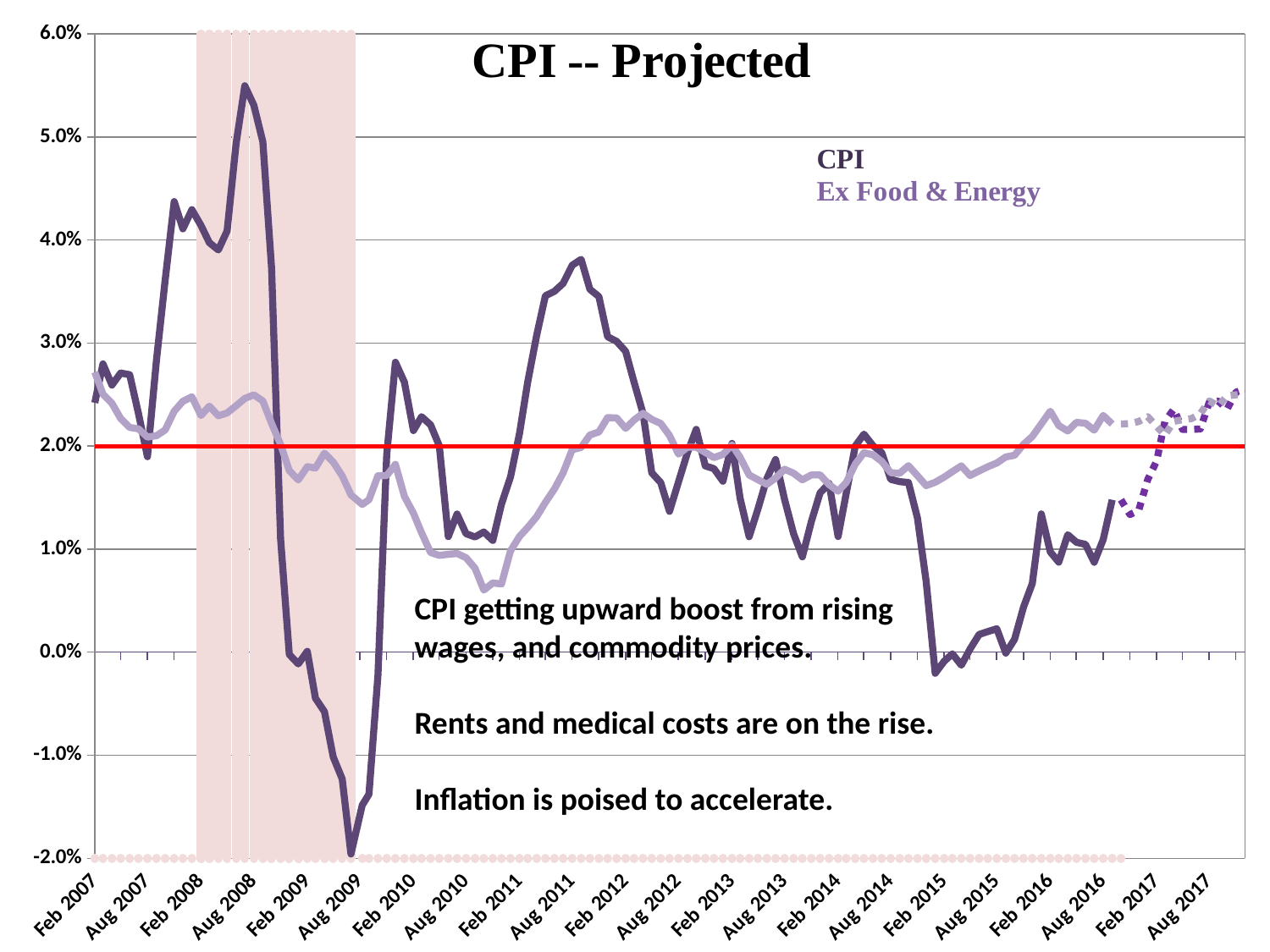
What value on the y axis does the horizontal red line mark? 2.0% Does the CPI series rise or fall between Feb 2015 and Aug 2016? rise Is the lowest value of the CPI series around Aug 2009 greater or less than -1.0%? less Around Aug 2009, which series has the higher value, CPI or Ex Food & Energy? Ex Food & Energy What kind of chart is shown on the slide? line chart Which series reaches the highest value anywhere on the chart? CPI Around Aug 2011, which series has the higher value, CPI or Ex Food & Energy? CPI Is the value of the CPI series around Aug 2011 greater or less than 3.0%? greater Is the peak value of the CPI series around Aug 2008 greater or less than 5.0%? greater What is the title of the chart? CPI -- Projected How many series does the legend list? 2